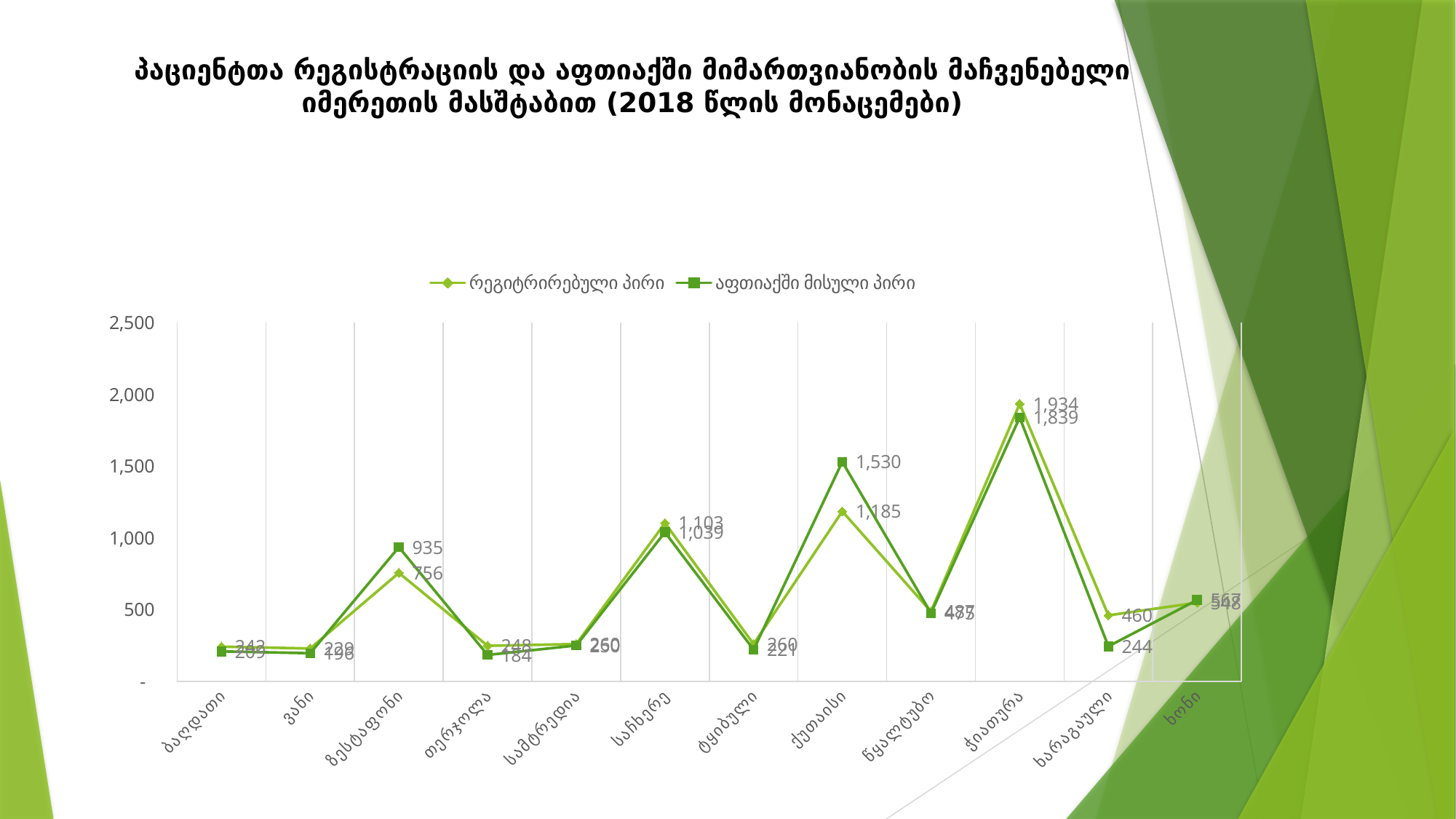
What is the difference between აფთიაქში მისული პირი and რეგიტრირებული პირი for ქუთაისი? 345 Is the value of აფთიაქში მისული პირი for ხარაგაული greater or less than 500? less How many series does the legend list? 2 What is the value of აფთიაქში მისული პირი for ქუთაისი? 1,530 What is the value of აფთიაქში მისული პირი for ზესტაფონი? 935 Which category has the highest value for რეგიტრირებული პირი? ჭიათურა What is the difference between რეგიტრირებული პირი and აფთიაქში მისული პირი for ჭიათურა? 95 For ზესტაფონი, which series has the larger value, რეგიტრირებული პირი or აფთიაქში მისული პირი? აფთიაქში მისული პირი How many categories are shown on the x axis? 12 What is the value of რეგიტრირებული პირი for ჭიათურა? 1,934 What kind of chart is shown on the slide? line chart What is the value of რეგიტრირებული პირი for ხარაგაული? 460